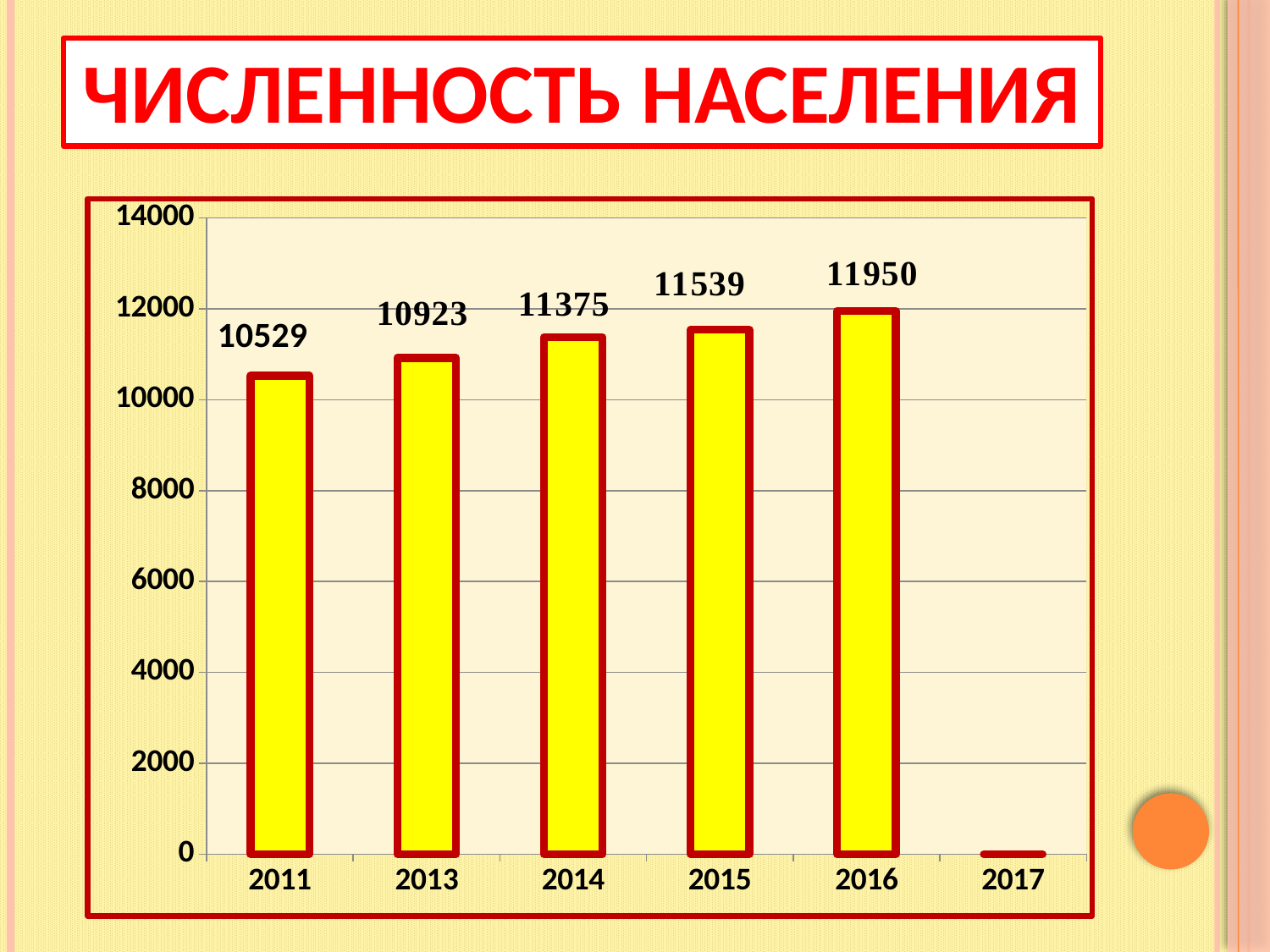
What is the difference between the values for 2016 and 2011? 1421 What is the value shown for 2011? 10529 What is the value shown for 2014? 11375 What is the value shown for 2016? 11950 What is the title of the slide? ЧИСЛЕННОСТЬ НАСЕЛЕНИЯ What is the difference between the values for 2015 and 2014? 164 Which is larger, the value for 2013 or the value for 2015? 2015 Among the years with a printed value, which has the lowest value? 2011 How many years are labelled on the x axis? 6 Which year has the highest value on the chart? 2016 Is the value for 2011 greater or less than 12000? less What type of chart is shown on the slide? bar chart